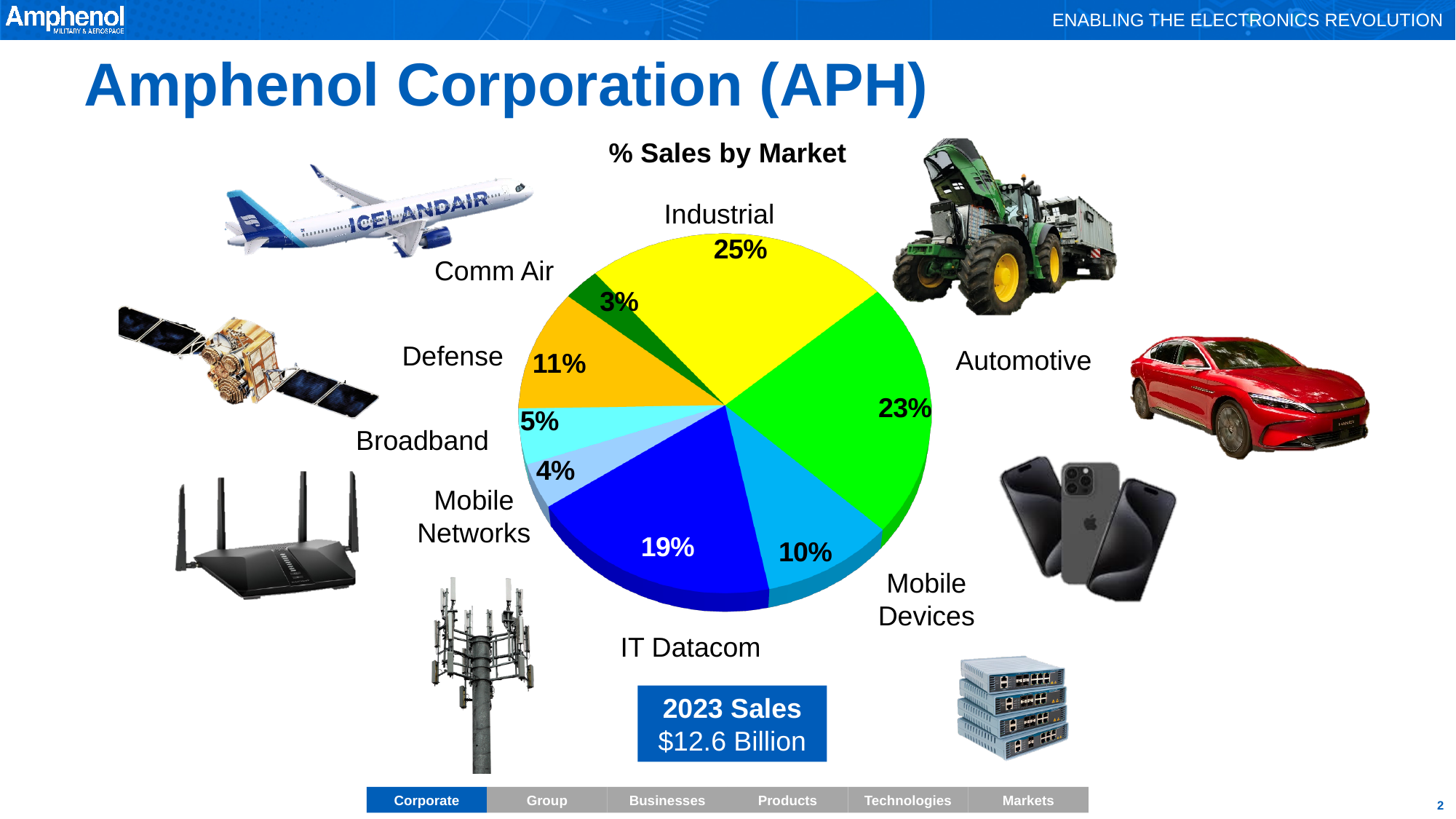
Which market has the smallest share of sales? Comm Air What percentage of sales comes from the Industrial market? 25% What type of chart is shown on the slide? pie chart How many market segments are shown in the pie chart? 8 Which has a larger share of sales, Mobile Devices or Broadband? Mobile Devices What percentage of sales comes from Defense? 11% What is the title of the chart? % Sales by Market What percentage of sales comes from IT Datacom? 19% Which market has the largest share of sales? Industrial What percentage of sales comes from the Automotive market? 23% What is the combined share of Mobile Networks and Broadband? 9% What is the difference in percentage points between the Industrial and Automotive shares? 2